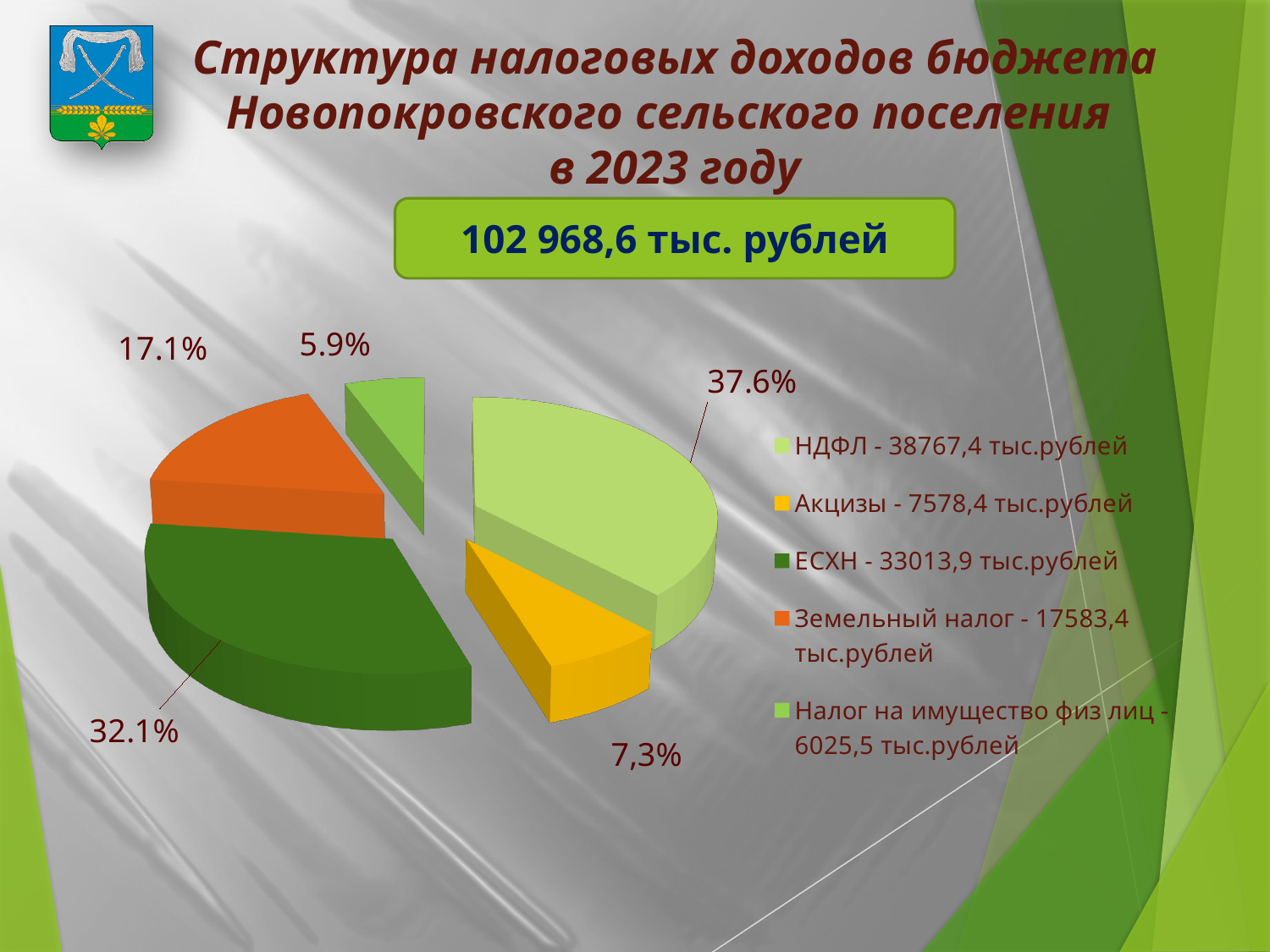
What share of the pie does НДФЛ represent? 37.6% What share of the pie does ЕСХН represent? 32.1% How many slices does the pie chart have? 5 How many entries does the legend list? 5 What share of the pie does Акцизы represent? 7,3% What total amount is shown in the box above the chart? 102 968,6 тыс. рублей What type of chart is shown on the slide? Pie chart According to the legend, what is the amount for ЕСХН? 33013,9 тыс.рублей Which category has the smallest share of the pie? Налог на имущество физ лиц Which category has the largest share of the pie? НДФЛ